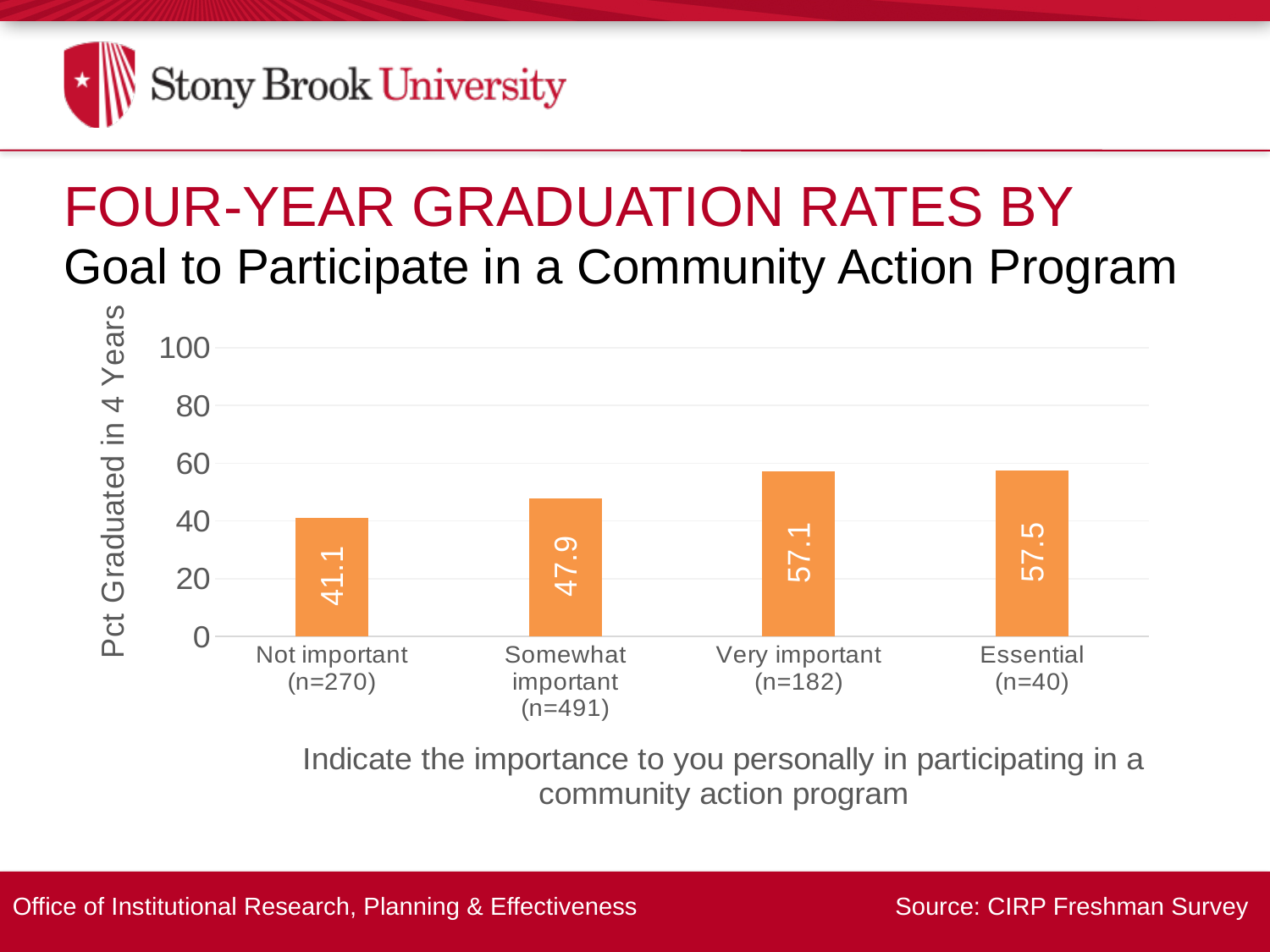
What is the four-year graduation rate for the Very important group? 57.1 What is the difference in four-year graduation rate between the Somewhat important and Not important groups? 6.8 What kind of chart is shown on the slide? Bar chart What is the four-year graduation rate for students who rated participating in a community action program as Not important? 41.1 Which category has the lowest four-year graduation rate? Not important What is the four-year graduation rate for the Essential group? 57.5 What is the four-year graduation rate for the Somewhat important group? 47.9 What is the difference in four-year graduation rate between the Very important and Not important groups? 16 What is the sample size (n) for the Somewhat important group? 491 Which group has a higher four-year graduation rate, Somewhat important or Very important? Very important Which category has the highest four-year graduation rate? Essential How many categories are shown on the x axis of the chart? 4